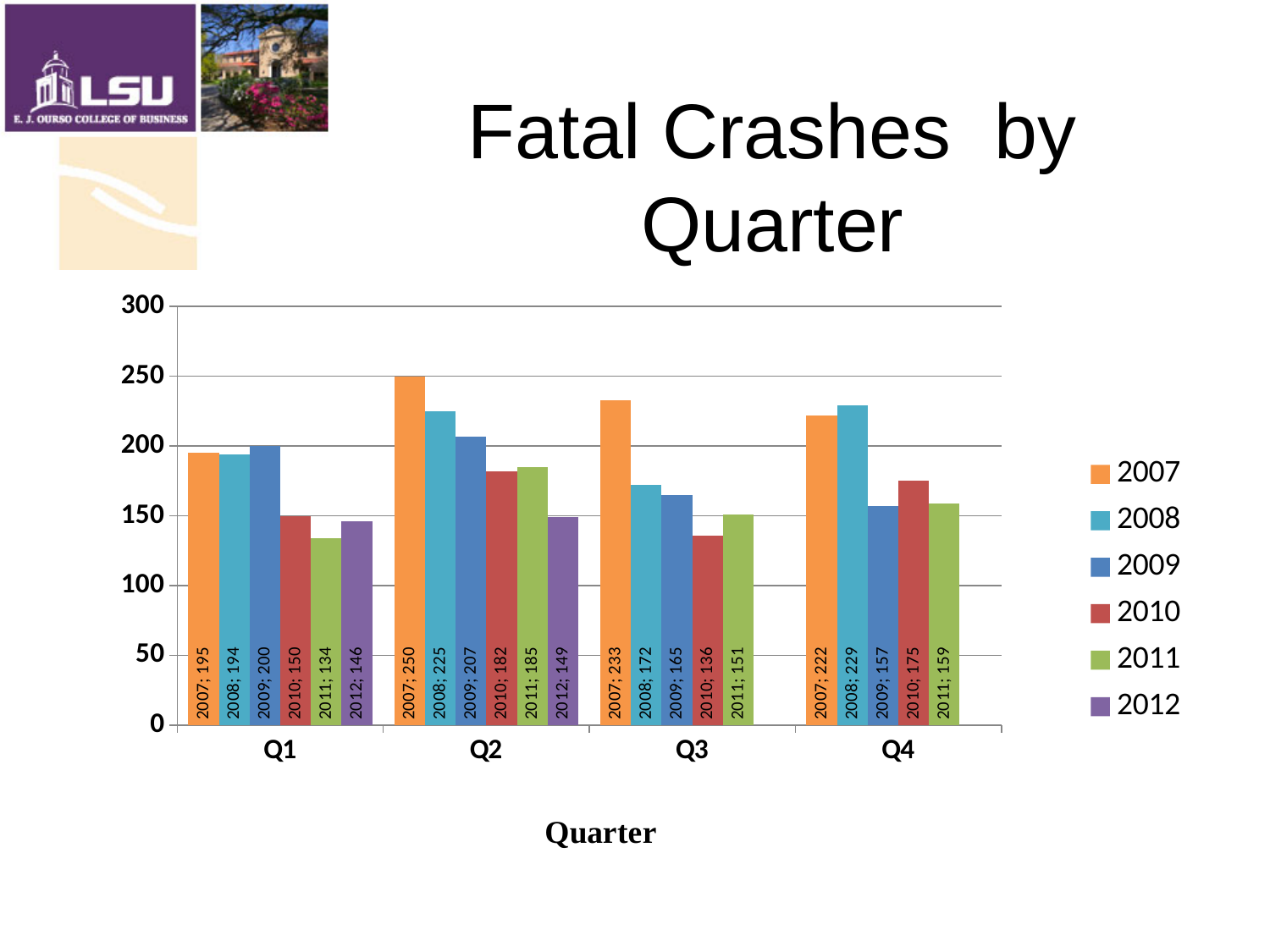
Which is larger in Q4, the value for 2007 or the value for 2008? 2008 Which year has the highest value in Q3? 2007 How many series does the legend list? 6 How many quarters are shown on the x axis? 4 What is the value for 2010 in Q4? 175 Is the value for 2009 in Q2 greater or less than 200? greater What is the value for 2007 in Q2? 250 What kind of chart is shown on the slide? bar chart What is the value for 2011 in Q1? 134 What is the difference between the 2007 and 2008 values in Q3? 61 Which year has the lowest value in Q2? 2012 What is the title of the chart? Fatal Crashes by Quarter